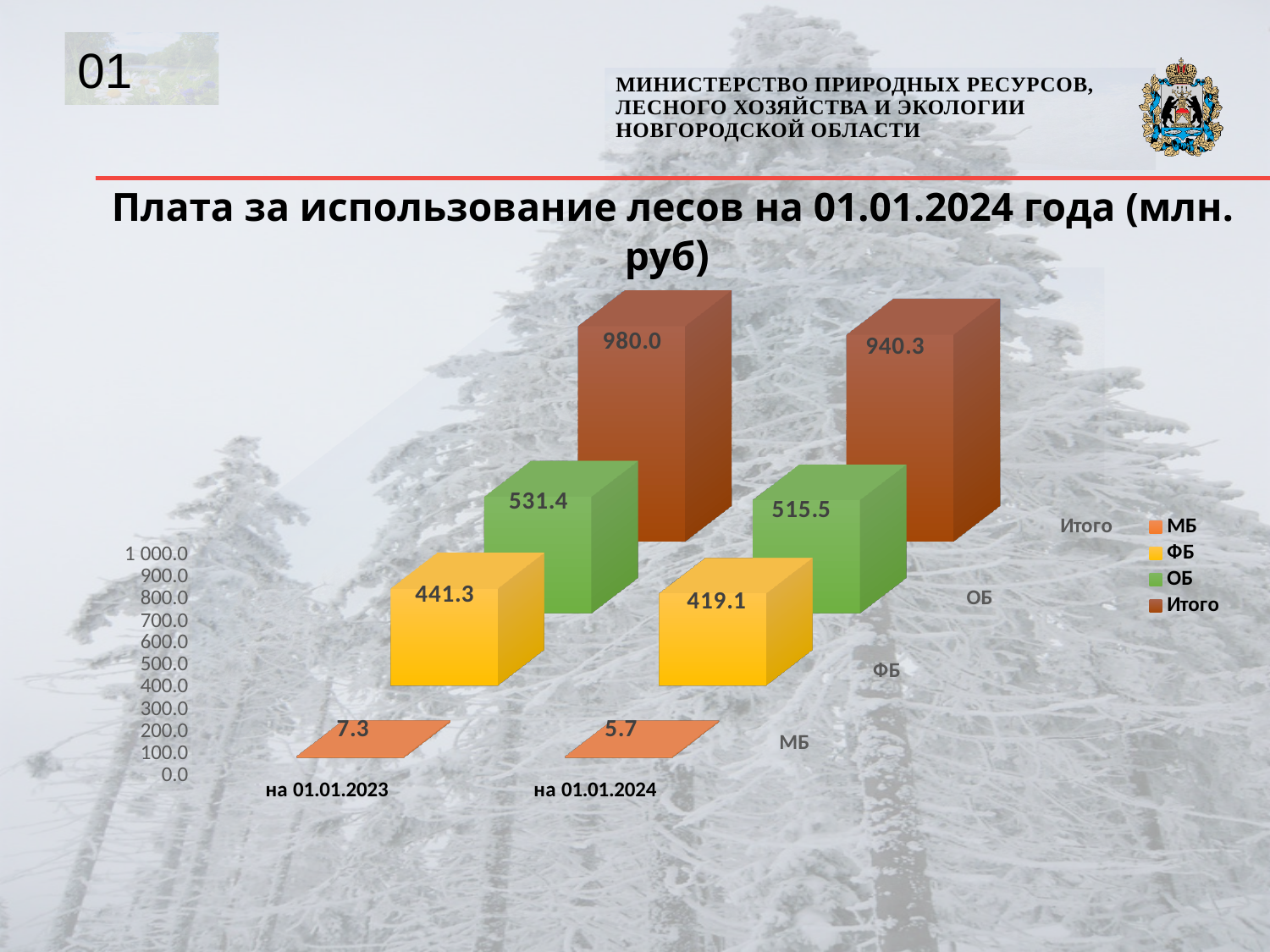
Which is larger: ОБ on 01.01.2023 or ОБ on 01.01.2024? ОБ on 01.01.2023 What is the Итого value on 01.01.2024? 940.3 Which series has the highest value on 01.01.2023? Итого Does the ФБ value rise or fall from 01.01.2023 to 01.01.2024? Fall How many categories are shown on the x axis? 2 What is the value for ФБ on 01.01.2023? 441.3 What is the difference between the Итого values on 01.01.2023 and 01.01.2024? 39.7 Which series has the lowest value on 01.01.2024? МБ What is the value for ОБ on 01.01.2024? 515.5 What is the value for МБ on 01.01.2023? 7.3 How many series does the legend list? 4 What kind of chart is shown on the slide? Bar chart